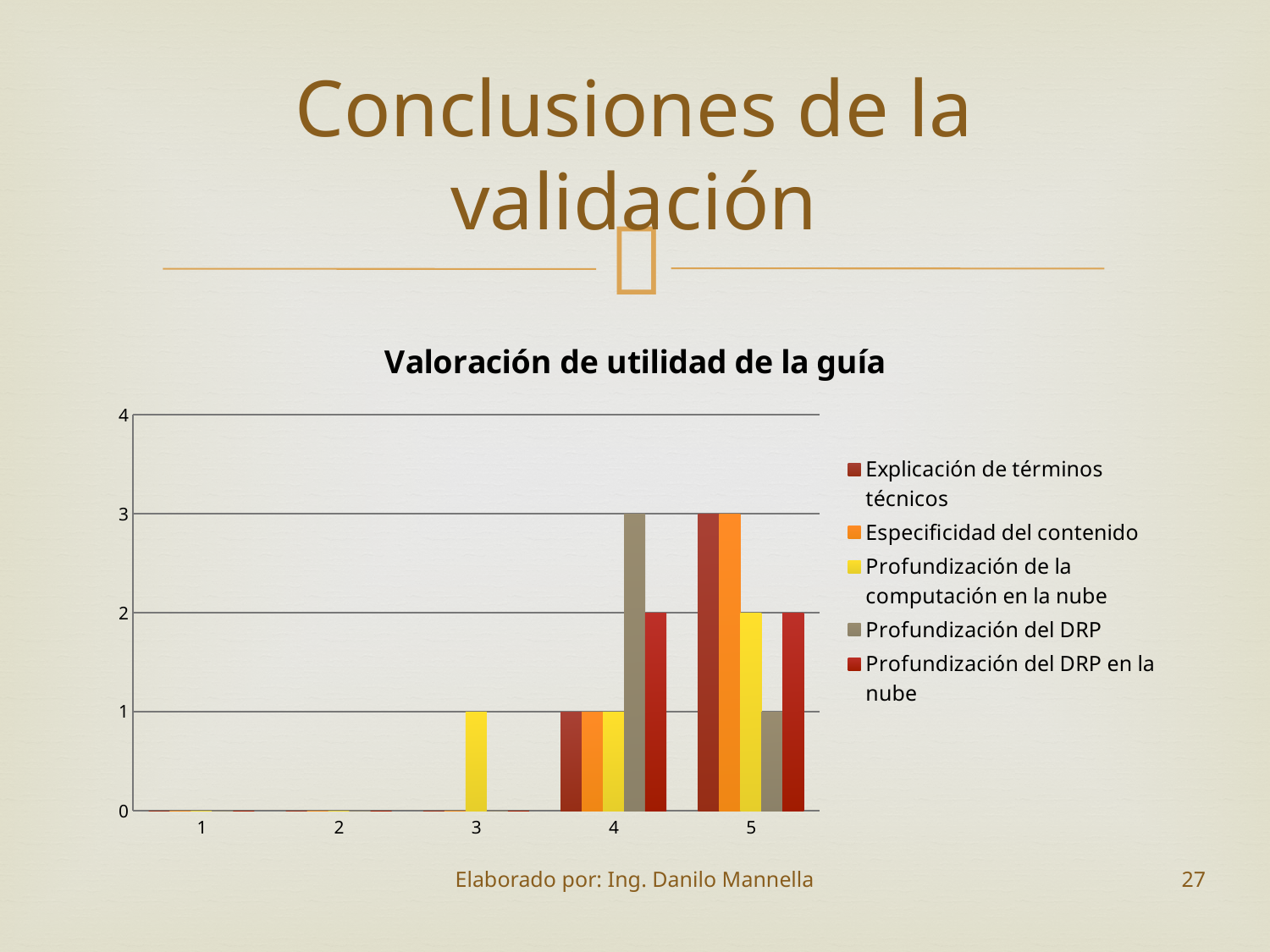
What is the difference between Profundización del DRP at category 4 and at category 5? 2 How many categories are shown on the x axis? 5 How many series does the legend list? 5 What is the value for Profundización de la computación en la nube at category 3? 1 What is the value for Explicación de términos técnicos at category 5? 3 What is the value for Profundización del DRP en la nube at category 5? 2 Which series is shown in yellow in the legend? Profundización de la computación en la nube What is the value for Profundización del DRP at category 4? 3 What kind of chart is shown on the slide? Bar chart What is the title of the chart? Valoración de utilidad de la guía Which is larger at category 5: Especificidad del contenido or Profundización del DRP? Especificidad del contenido Which series has the highest value at category 4? Profundización del DRP